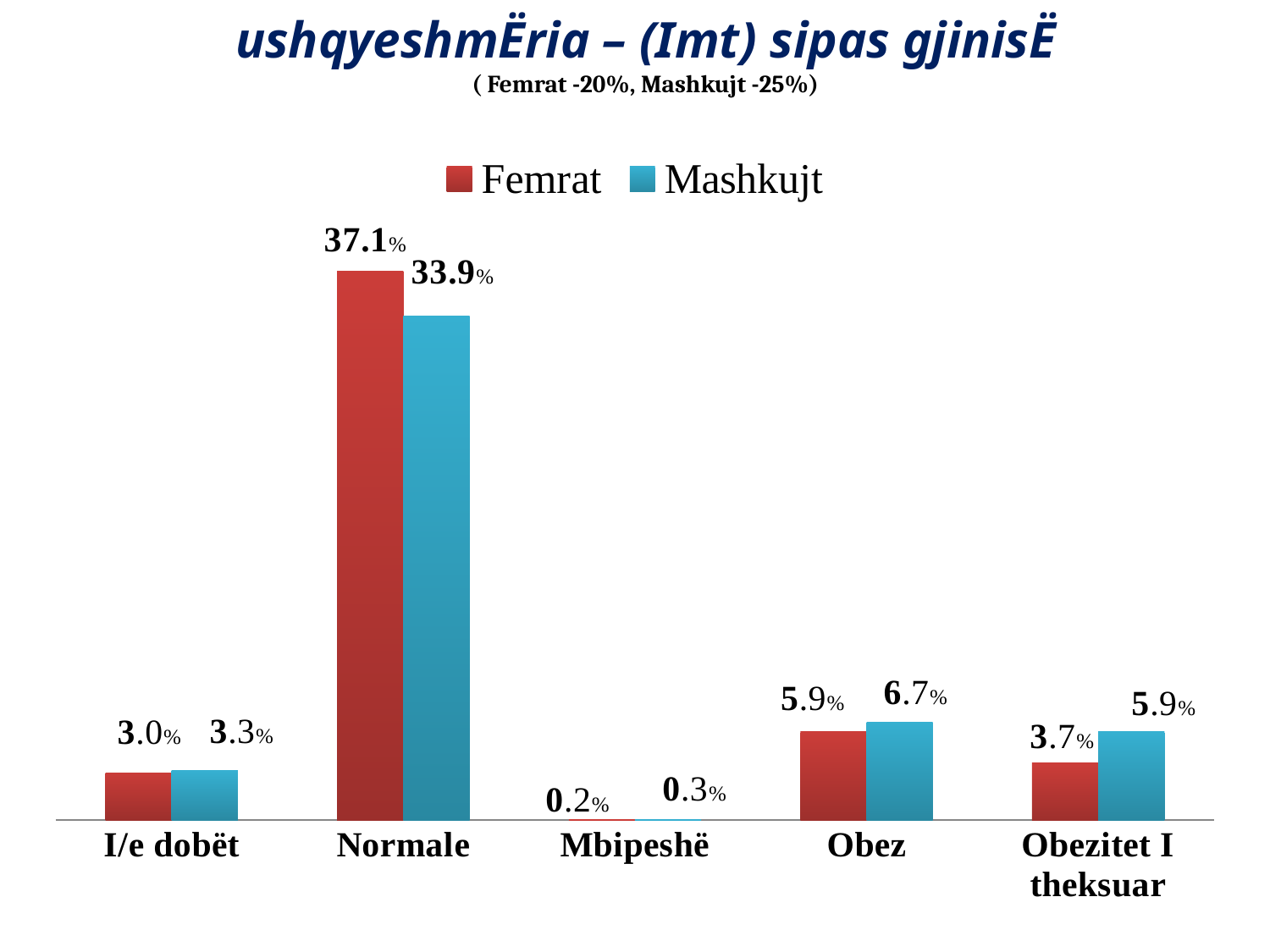
What is the value for Mashkujt in the Obez category? 6.7% What kind of chart is shown on the slide? Bar chart Which colour represents the Femrat series in the legend? Red How many series does the legend list? 2 How many categories are shown on the x axis? 5 What is the value for Mashkujt in the Mbipeshë category? 0.3% In the Obezitet I theksuar category, which series has the larger value, Femrat or Mashkujt? Mashkujt Which category has the lowest value for Femrat? Mbipeshë What is the value for Femrat in the Normale category? 37.1% What is the difference between the Femrat and Mashkujt values in the Normale category? 3.2% Which category has the highest value for Mashkujt? Normale What is the value for Femrat in the Obezitet I theksuar category? 3.7%